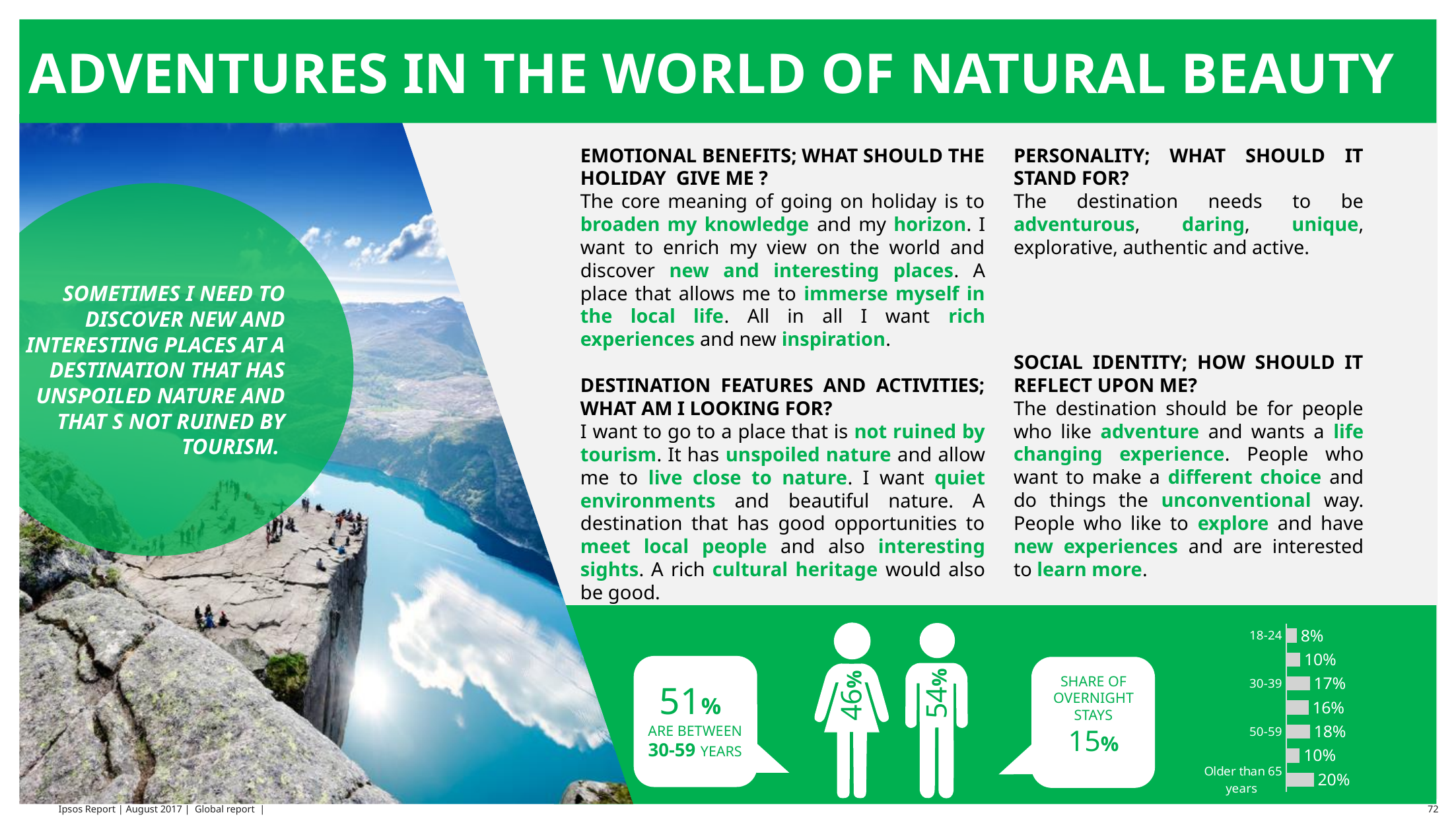
In the age-group bar chart, which is larger: the value for 50-59 or the value for 30-39? 50-59 According to the infographic at the bottom of the slide, what percentage of this segment is female? 46% In the age-group bar chart, what is the value for the 'Older than 65 years' group? 20% In the age-group bar chart, what is the value for the 18-24 group? 8% In the age-group bar chart, which labelled age group has the highest value? Older than 65 years In the age-group bar chart, what is the value for the 50-59 group? 18% What kind of chart is the age-group chart at the bottom right of the slide? Bar chart How many bars are plotted in the age-group bar chart? 7 In the age-group bar chart, which labelled age group has the lowest value? 18-24 According to the infographic at the bottom of the slide, what is the share of overnight stays? 15% In the age-group bar chart, what is the difference between the 'Older than 65 years' value and the 18-24 value? 12 percentage points In the age-group bar chart, what is the value for the 30-39 group? 17%